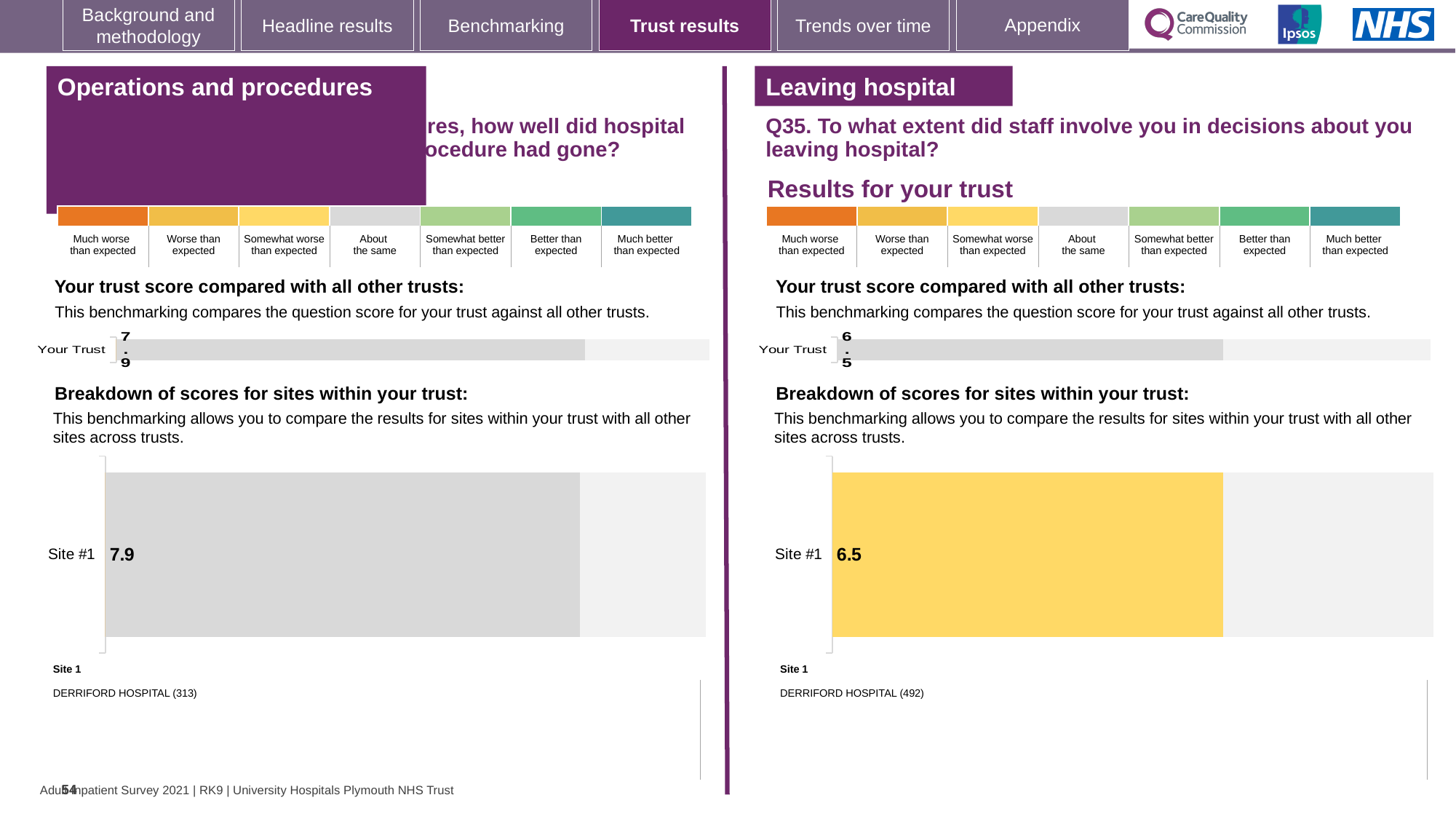
On the 'Operations and procedures' site breakdown chart, what is the score for Site #1? 7.9 On the 'Leaving hospital' site breakdown chart, what is the score for Site #1? 6.5 What is the difference between the Your Trust score for 'Operations and procedures' and the Your Trust score for 'Leaving hospital'? 1.4 On the 'Leaving hospital' section, what is the score shown for Your Trust? 6.5 What type of chart is used for the Site #1 breakdown on the 'Leaving hospital' section? Bar chart Which is larger: the Site #1 score on the 'Operations and procedures' chart or the Site #1 score on the 'Leaving hospital' chart? Operations and procedures On the 'Operations and procedures' section, what is the score shown for Your Trust? 7.9 What is the difference between the Site #1 score on the 'Operations and procedures' chart and the Site #1 score on the 'Leaving hospital' chart? 1.4 Which site name is listed as Site 1 under the 'Leaving hospital' breakdown chart? DERRIFORD HOSPITAL (492) How many sites are shown in the 'Operations and procedures' site breakdown chart? 1 How many sites are shown in the 'Leaving hospital' site breakdown chart? 1 On the 'Leaving hospital' site breakdown chart, what colour is the Site #1 bar? Yellow